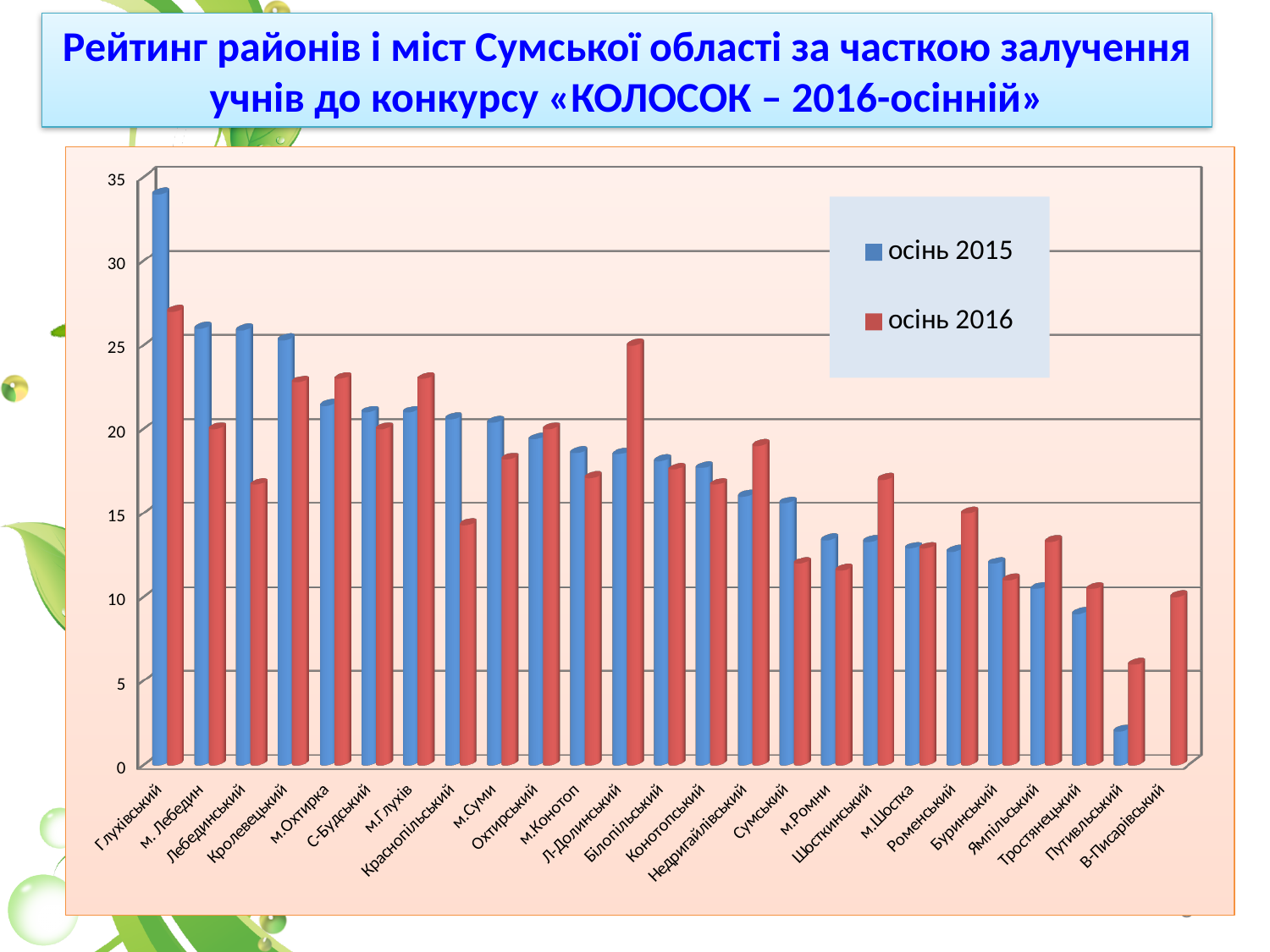
How many series does the legend list? 2 How many districts and cities are shown along the x axis? 25 Which category has the lowest value for осінь 2016? Путивльський Is the осінь 2016 value for Л-Долинський greater or less than 20? greater Which category has the highest value for осінь 2016? Глухівський Do the осінь 2015 values generally rise or fall from left to right along the x axis? fall Is the осінь 2015 value for Глухівський greater or less than 30? greater What are the two series named in the legend? осінь 2015 and осінь 2016 Is the осінь 2015 value for Путивльський greater or less than 5? less What kind of chart is shown on the slide? bar chart For Шосткинський, which is larger: the осінь 2015 value or the осінь 2016 value? осінь 2016 Which category has the highest value for осінь 2015? Глухівський